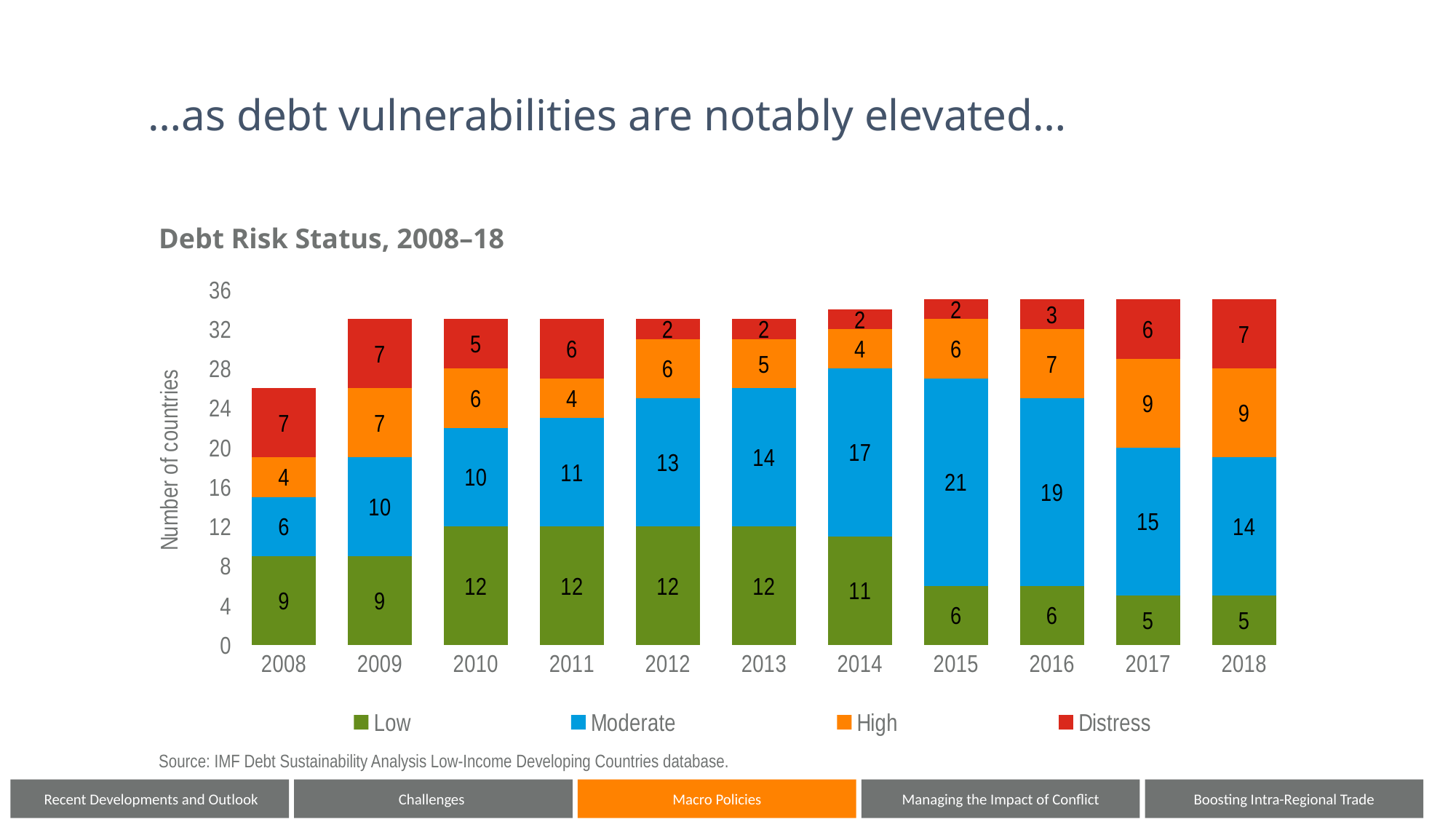
How many years are shown on the x axis? 11 What is the Moderate value for 2015? 21 In which year is the Moderate value highest? 2015 What type of chart is shown on the slide? Stacked bar chart What is the Low value for 2010? 12 What is the total number of countries in the 2008 bar? 26 What is the Distress value for 2018? 7 How many series does the legend list? 4 What is the total number of countries in the 2018 bar? 35 Which is larger, the Distress value in 2012 or the Distress value in 2017? 2017 In which year is the Low value lowest? 2017 and 2018 What is the difference between the High value in 2017 and the High value in 2011? 5